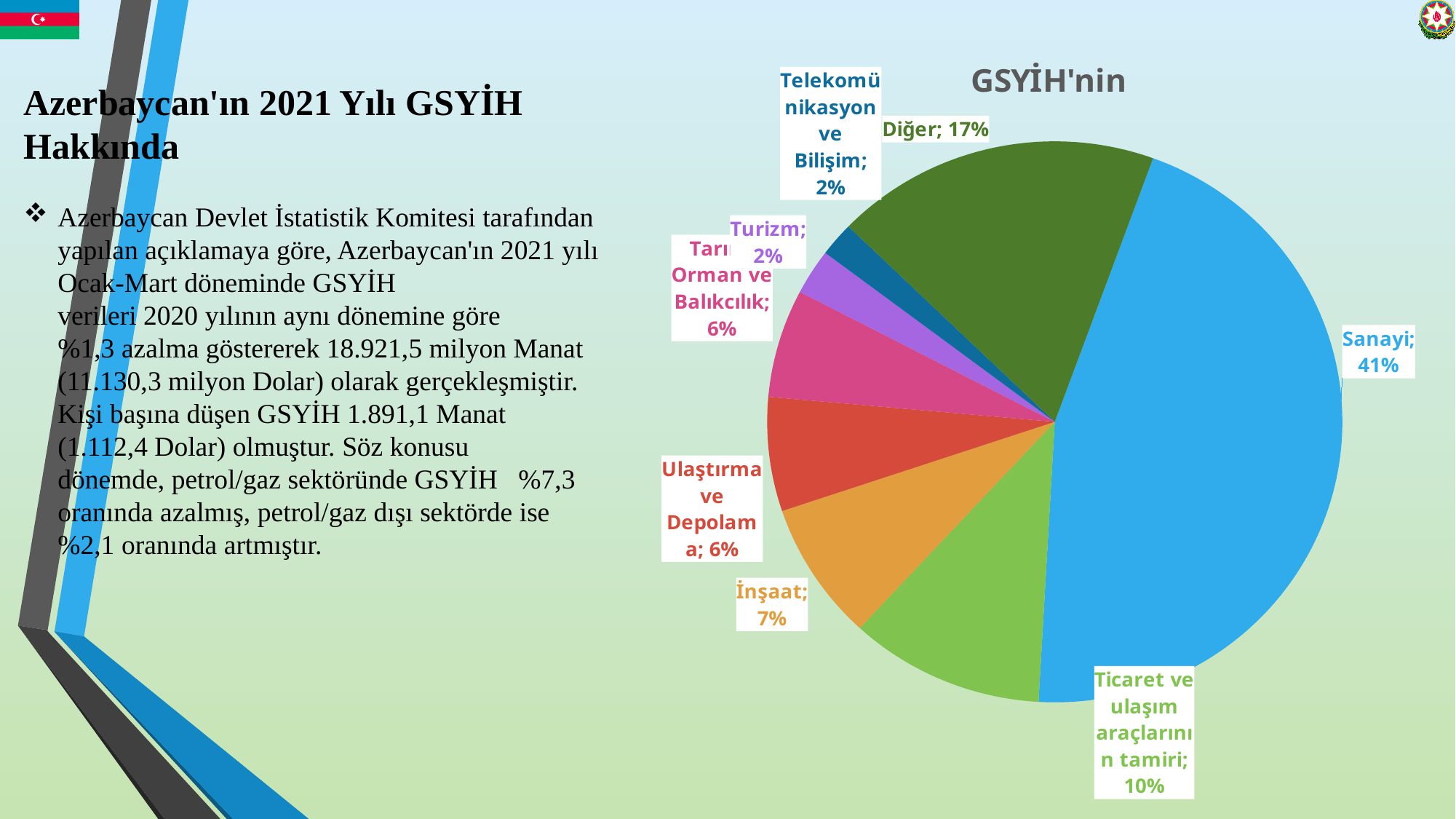
What is the title of the chart? GSYİH'nin What percentage is shown for Diğer? 17% What kind of chart is shown on the slide? Pie chart Which is larger, İnşaat or Ulaştırma ve Depolama? İnşaat What is the difference between the Sanayi share and the Diğer share? 24% What is the value labelled for İnşaat? 7% How many slices does the pie chart have? 8 Which category has the largest slice of the pie? Sanayi What share of the pie does Sanayi account for? 41% What percentage is shown for Ticaret ve ulaşım araçlarının tamiri? 10% Which is larger, Diğer or Ticaret ve ulaşım araçlarının tamiri? Diğer What is the value for Ulaştırma ve Depolama? 6%